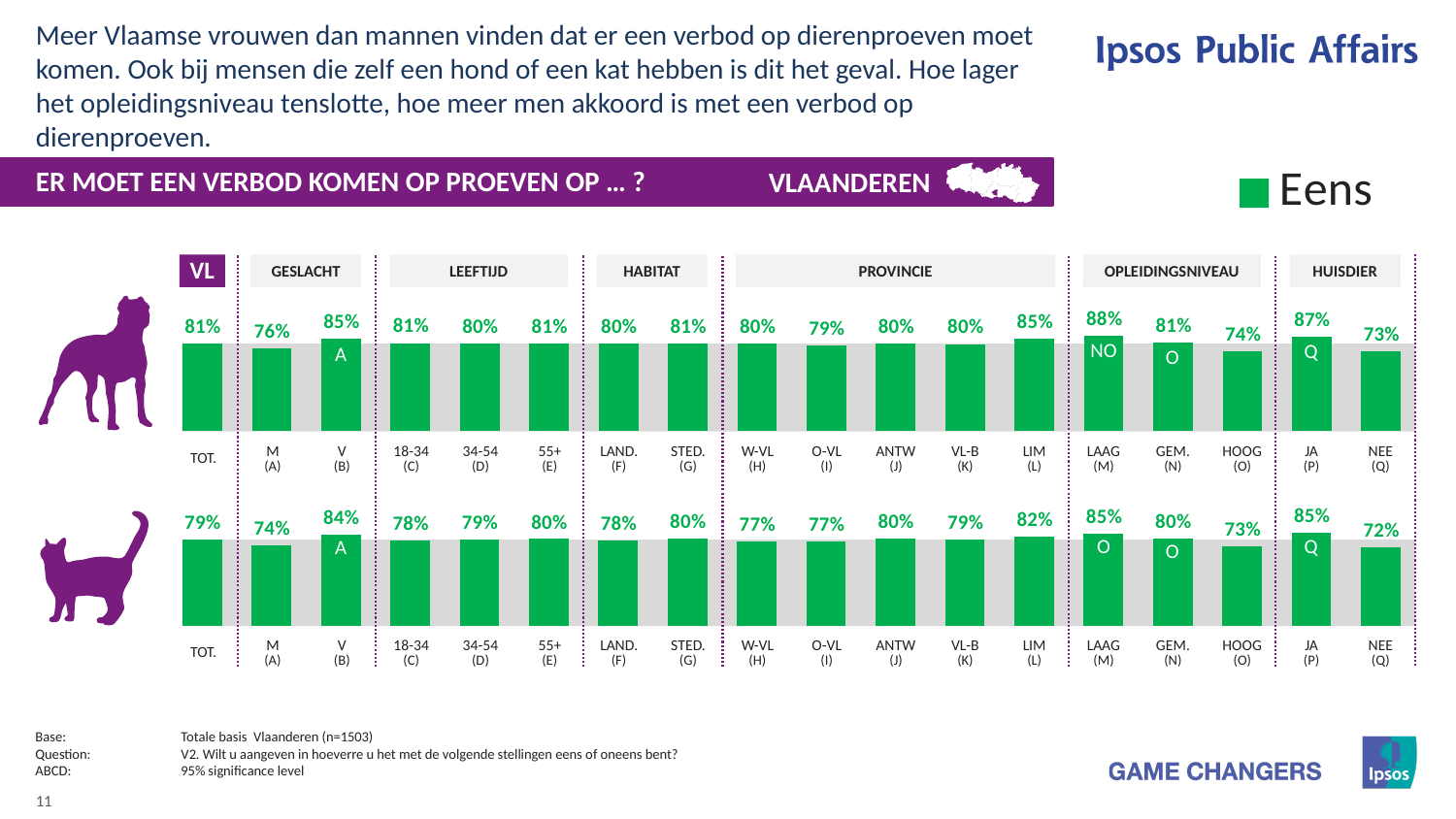
In the bottom chart (cat), which category under HUISDIER has the lowest value? NEE (Q) In the top chart (dog), what is the value for LIM (L) under PROVINCIE? 85% In the top chart (dog), what is the value for TOT.? 81% In the bottom chart (cat), what is the difference between the values for JA (P) and NEE (Q)? 13% What is the single legend entry shown on the slide? Eens In the bottom chart (cat), what is the value for V (B) under GESLACHT? 84% In the top chart (dog), what is the difference between the values for V (B) and M (A)? 9% In the top chart (dog), which category under OPLEIDINGSNIVEAU has the highest value? LAAG (M) In the bottom chart (cat), what is the value for HOOG (O) under OPLEIDINGSNIVEAU? 73% What kind of chart is used on this slide? Bar chart In the top chart (dog), which is larger: the value for LAAG (M) or the value for HOOG (O)? LAAG (M) How many categories are shown under PROVINCIE in the bottom chart (cat)? 5